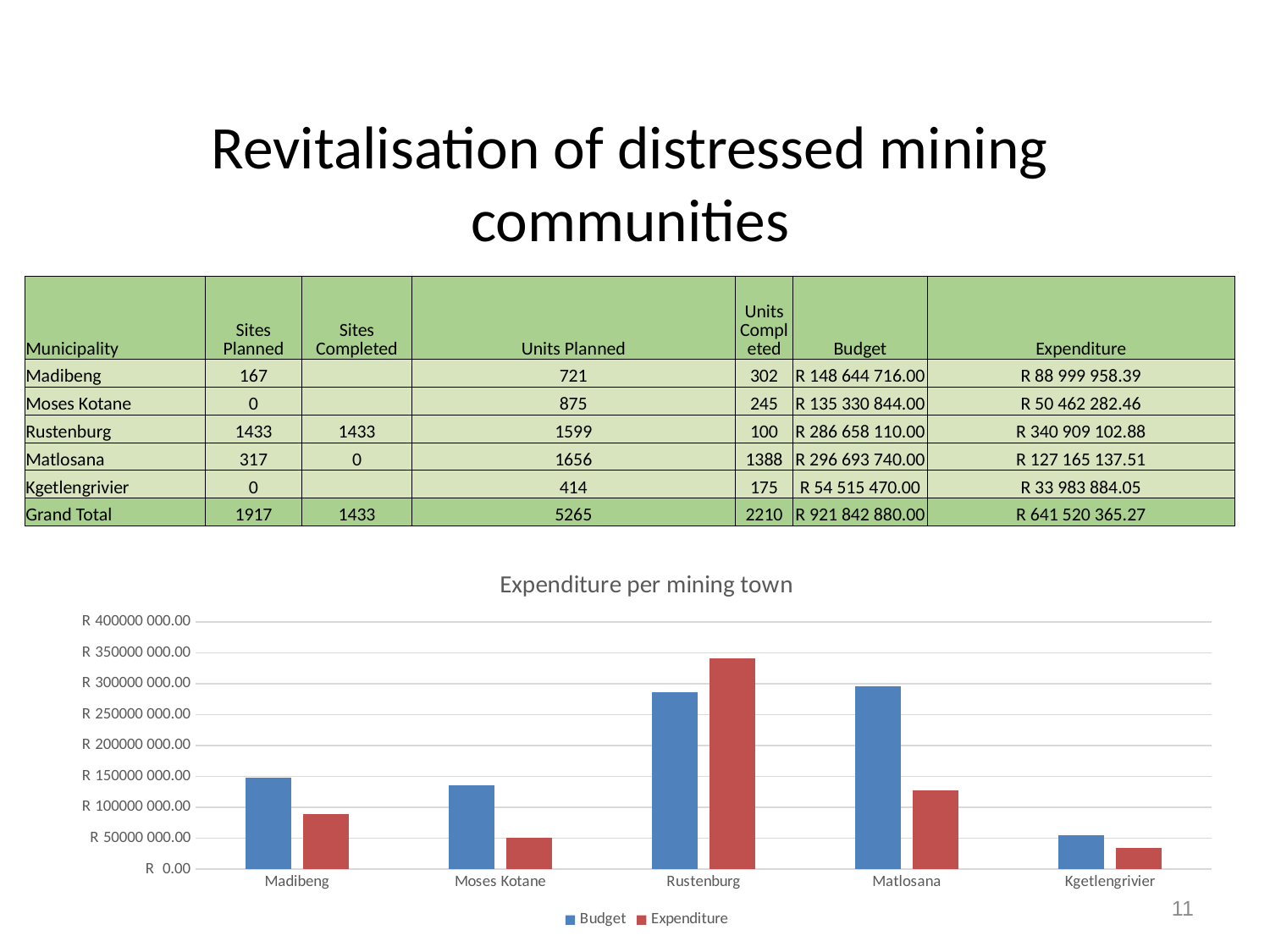
Is the Expenditure value for Rustenburg greater or less than R 300000 000.00? greater Which municipality has the lowest Budget bar in the chart? Kgetlengrivier How many municipalities are shown on the x axis of the chart? 5 What is the title of the chart? Expenditure per mining town How many series does the chart legend list? 2 Is the Expenditure value for Madibeng greater or less than R 100000 000.00? less Which municipality has the highest Expenditure bar in the chart? Rustenburg Which is the only municipality in the chart whose Expenditure bar is taller than its Budget bar? Rustenburg Which municipality has the lowest Expenditure bar in the chart? Kgetlengrivier Which colour represents the Expenditure series in the chart? Red For Madibeng, which is larger in the chart, Budget or Expenditure? Budget What kind of chart is shown on the slide? Bar chart